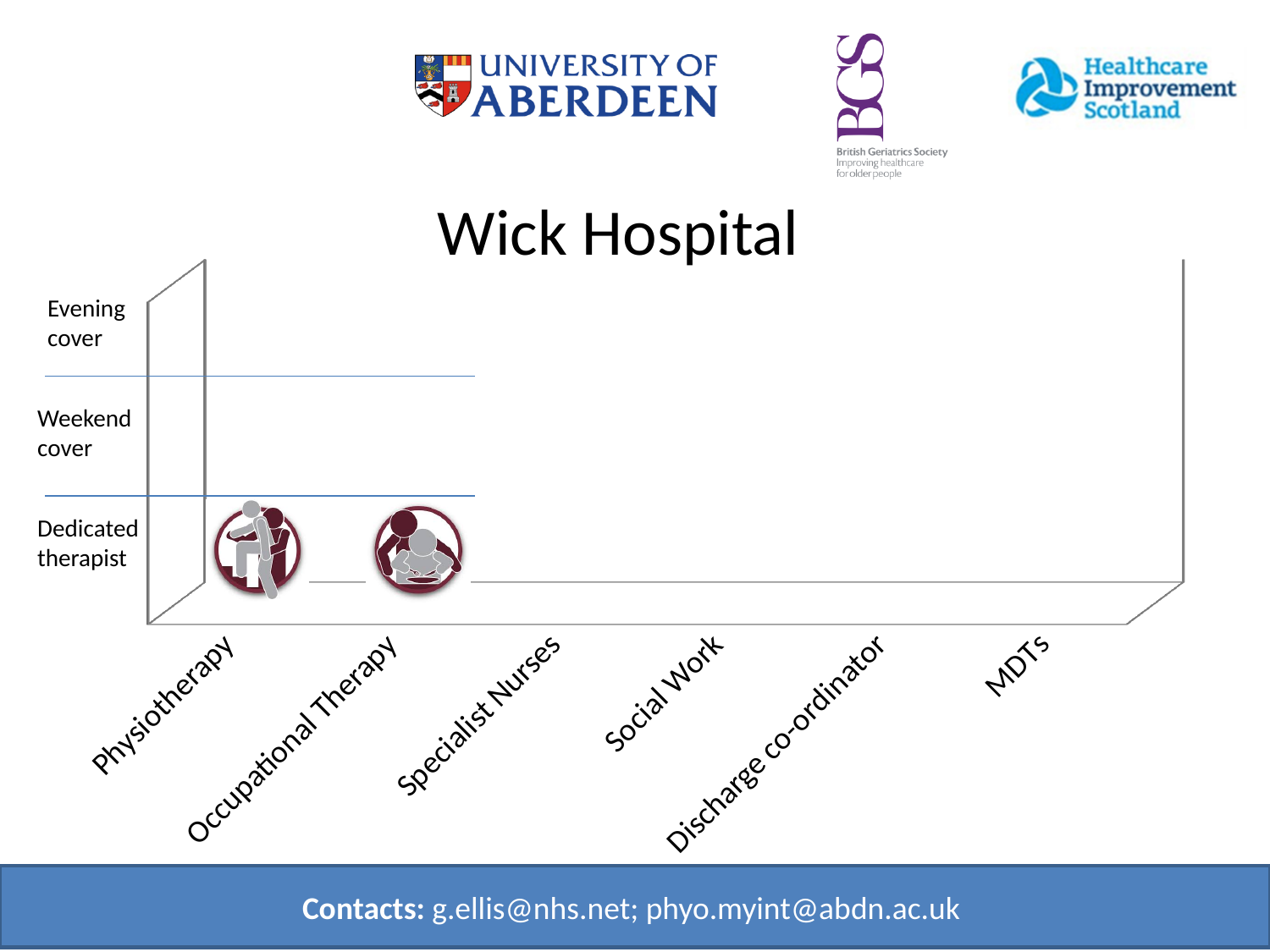
What is the first category on the x axis of the chart? Physiotherapy Which categories have an icon plotted in the chart? Physiotherapy and Occupational Therapy At which level is the icon for Physiotherapy plotted? Dedicated therapist At which level is the icon for Occupational Therapy plotted? Dedicated therapist Which level of cover is shown at the top of the vertical axis? Evening cover How many categories are listed along the x axis of the chart? 6 How many categories have an icon plotted in the chart? 2 What is the last category on the x axis of the chart? MDTs What is the title of the chart? Wick Hospital Which level is shown at the bottom of the vertical axis? Dedicated therapist Does Specialist Nurses have an icon plotted in the chart? No How many levels are labelled on the vertical axis of the chart? 3